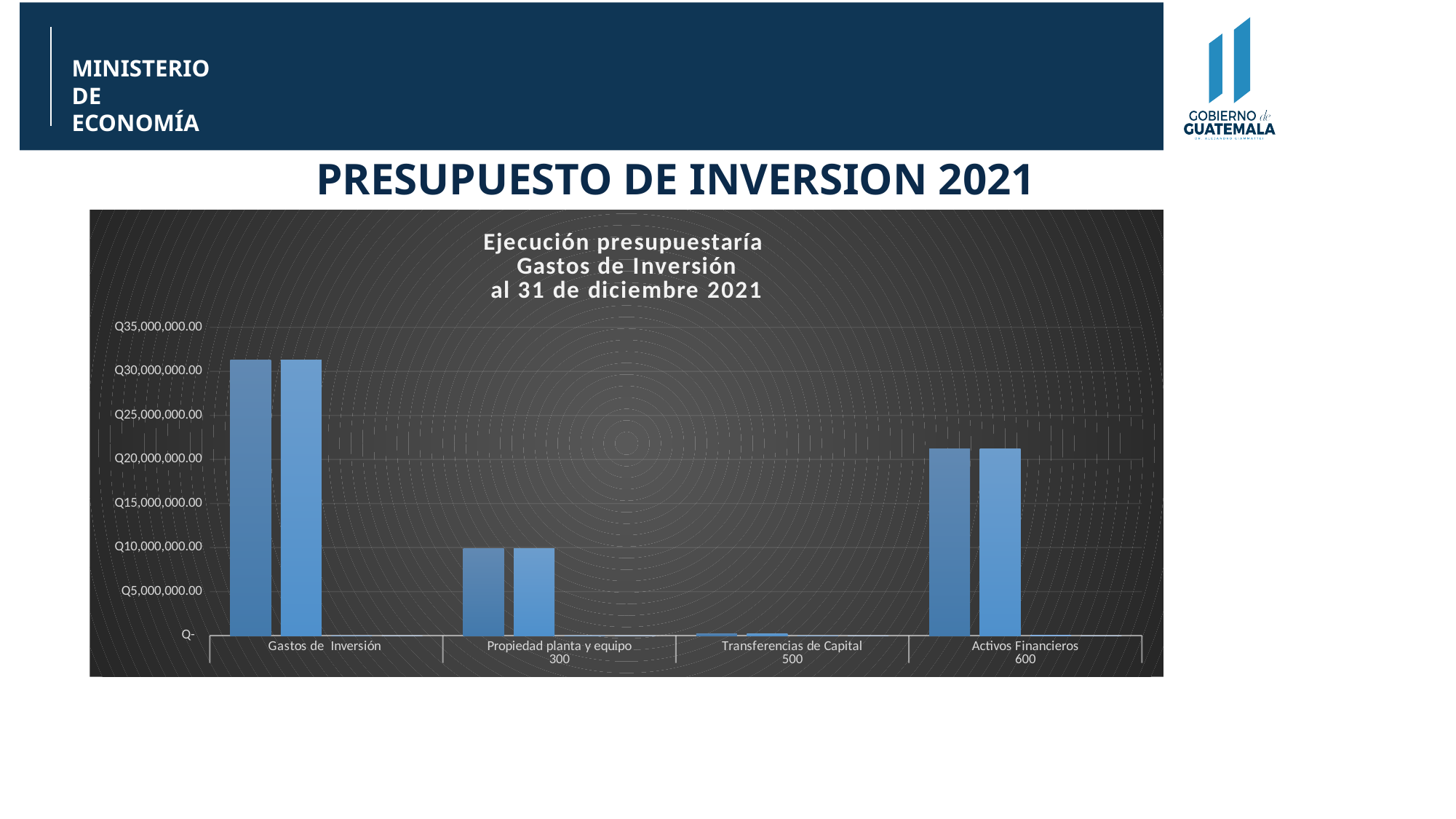
Which category has larger values, Activos Financieros or Propiedad planta y equipo? Activos Financieros What kind of chart is shown on the slide? bar chart Is the value for Gastos de Inversión greater or less than Q25,000,000.00? greater Which category has the highest bars in the chart? Gastos de Inversión Which category has the lowest bars in the chart? Transferencias de Capital How many categories are shown on the x axis of the chart? 4 Is the value for Activos Financieros greater or less than Q25,000,000.00? less Is the value for Propiedad planta y equipo greater or less than Q5,000,000.00? greater Which category has larger values, Gastos de Inversión or Activos Financieros? Gastos de Inversión What is the title of the chart? Ejecución presupuestaría Gastos de Inversión al 31 de diciembre 2021